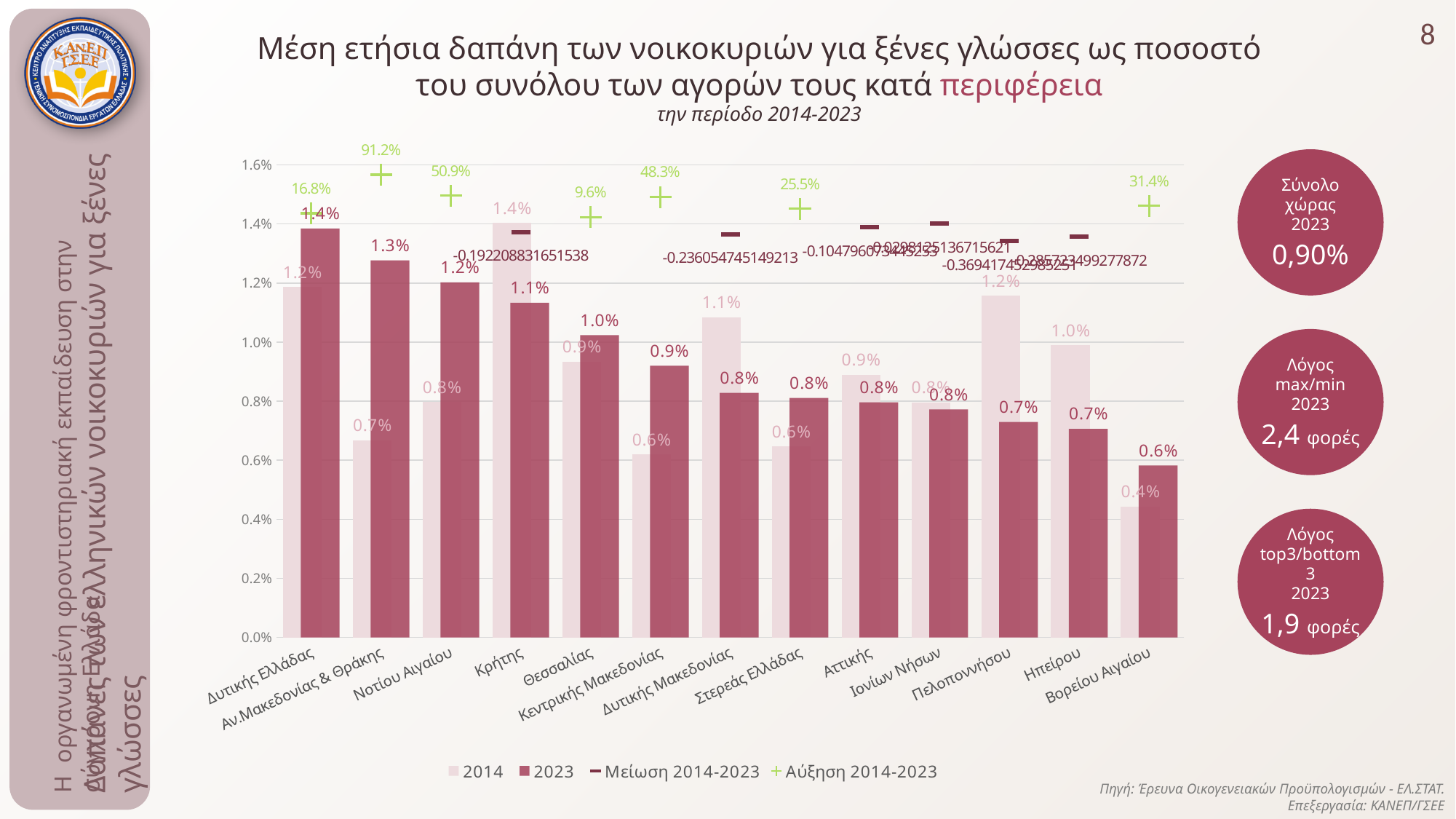
What percentage increase (Αύξηση 2014-2023) is shown for Νοτίου Αιγαίου? 50.9% Which region shows the largest percentage increase (Αύξηση 2014-2023)? Αν.Μακεδονίας & Θράκης How many regions (categories) are shown on the x axis of the chart? 13 What is the 2023 value for Δυτικής Ελλάδας? 1.4% Which region has the lowest 2014 value? Βορείου Αιγαίου For Κρήτης, which is larger: the 2014 value or the 2023 value? 2014 How many series does the chart legend list? 4 Do the 2023 values rise or fall moving from left to right along the x axis? fall What is the 2014 value for Αν.Μακεδονίας & Θράκης? 0.7% What kind of chart is shown on the slide? bar chart Which region has the highest 2023 value? Δυτικής Ελλάδας Is the 2014 value for Πελοποννήσου greater or less than 1.0%? greater